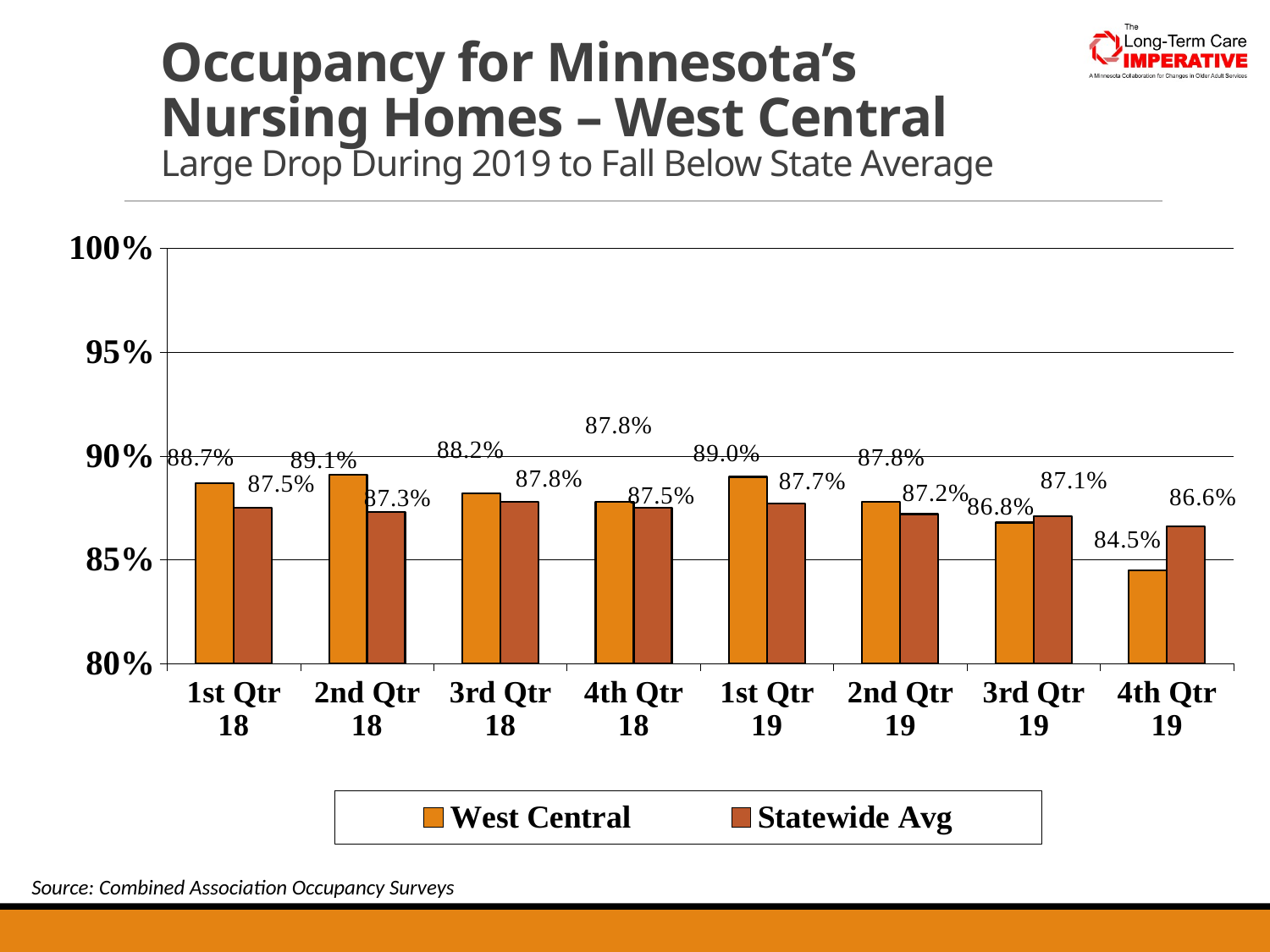
In 2nd Qtr 18, which is larger: West Central or Statewide Avg? West Central In which quarter is the West Central occupancy lowest? 4th Qtr 19 What is the Statewide Avg value for 1st Qtr 18? 87.5% What is the difference between the Statewide Avg and West Central values in 4th Qtr 19? 2.1 percentage points How many quarters are shown on the x axis? 8 What is the West Central value for 1st Qtr 19? 89.0% How many series does the legend list? 2 Is the West Central value for 4th Qtr 19 greater or less than 85%? less In which quarter is the West Central occupancy highest? 2nd Qtr 18 What kind of chart is shown on the slide? Bar chart What is the West Central occupancy value for 4th Qtr 19? 84.5% In which quarter is the Statewide Avg lowest? 4th Qtr 19